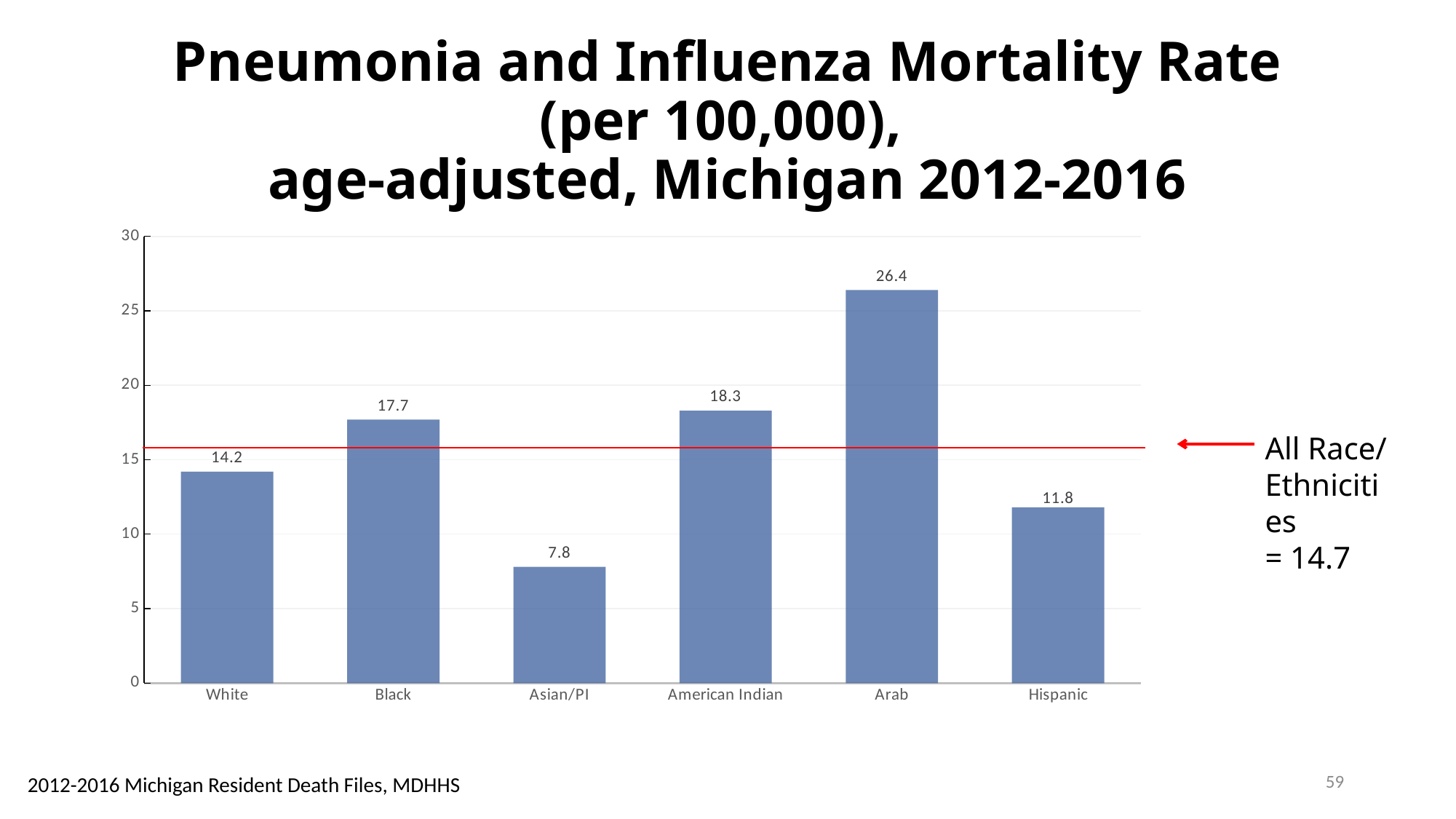
What is the mortality rate shown for the Hispanic group? 11.8 What kind of chart is shown on the slide? Bar chart What is the mortality rate shown for the Asian/PI group? 7.8 What is the pneumonia and influenza mortality rate for the Arab group? 26.4 Is the value for White greater or less than 15? less What is the difference between the mortality rates for American Indian and Black groups? 0.6 Which race/ethnicity group has the lowest mortality rate? Asian/PI What is the difference between the mortality rates for Arab and White groups? 12.2 What is the mortality rate for all race/ethnicities indicated by the red line? 14.7 Which race/ethnicity group has the highest mortality rate? Arab Which has a higher mortality rate, Black or Hispanic? Black How many race/ethnicity categories are shown on the chart? 6